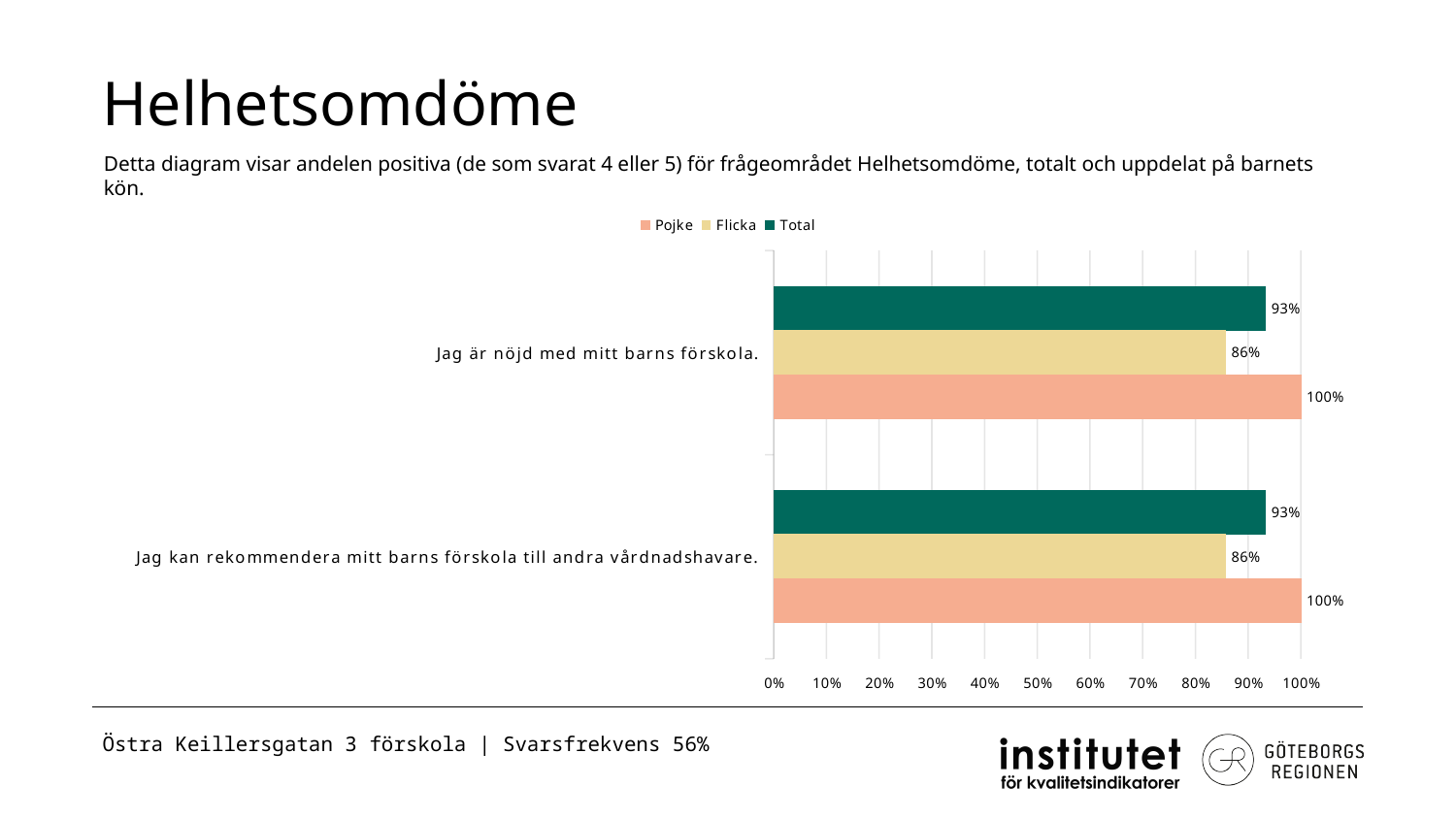
Which series is shown in dark green in the legend? Total What is the value for Pojke for "Jag är nöjd med mitt barns förskola."? 100% Which series has the highest value for "Jag är nöjd med mitt barns förskola."? Pojke Which series has the lowest value for "Jag kan rekommendera mitt barns förskola till andra vårdnadshavare."? Flicka How many series does the legend list? 3 What is the value for Flicka for "Jag är nöjd med mitt barns förskola."? 86% How many categories (statements) are plotted on the chart? 2 What is the value for Total for "Jag kan rekommendera mitt barns förskola till andra vårdnadshavare."? 93% Which is larger for "Jag kan rekommendera mitt barns förskola till andra vårdnadshavare.": the Total value or the Flicka value? Total What kind of chart is shown on the slide? bar chart What is the value for Flicka for "Jag kan rekommendera mitt barns förskola till andra vårdnadshavare."? 86% What is the difference between the Pojke and Flicka values for "Jag är nöjd med mitt barns förskola."? 14%